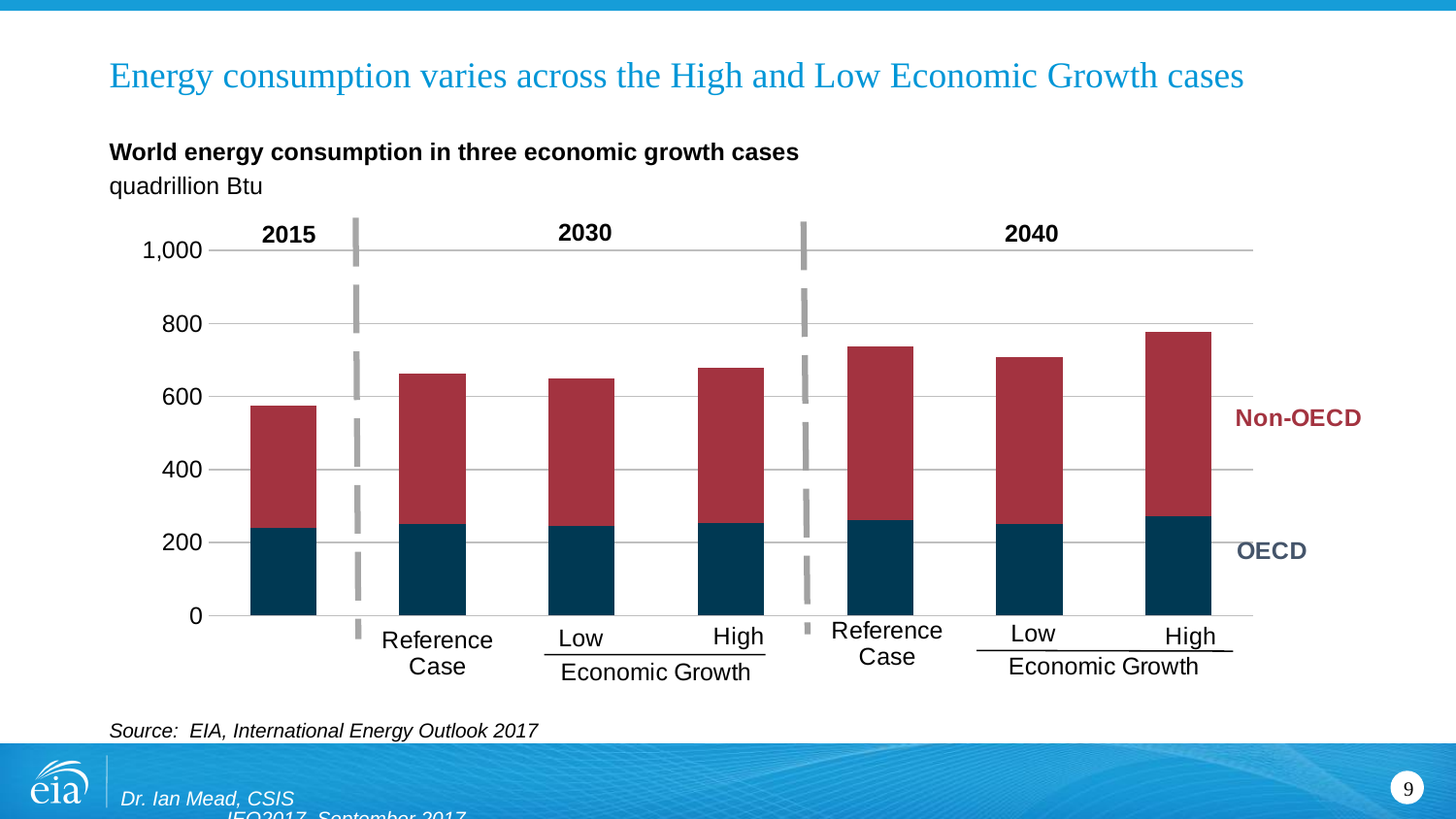
How many bars are plotted in the chart? 7 Which bar has the lowest total energy consumption? 2015 Is the total value for the 2040 High Economic Growth case greater or less than 600? greater Which bar has the highest total energy consumption? 2040 High Economic Growth Is the total value for 2015 greater or less than 600? less How many series does the chart show? 2 Do the Reference Case totals rise or fall from 2015 to 2040? rise What kind of chart is shown on the slide? stacked bar chart Is the OECD value for the 2030 Reference Case greater or less than 400? less What unit is the chart measured in? quadrillion Btu Which is larger in 2040: the total for the Low Economic Growth case or the High Economic Growth case? High Economic Growth